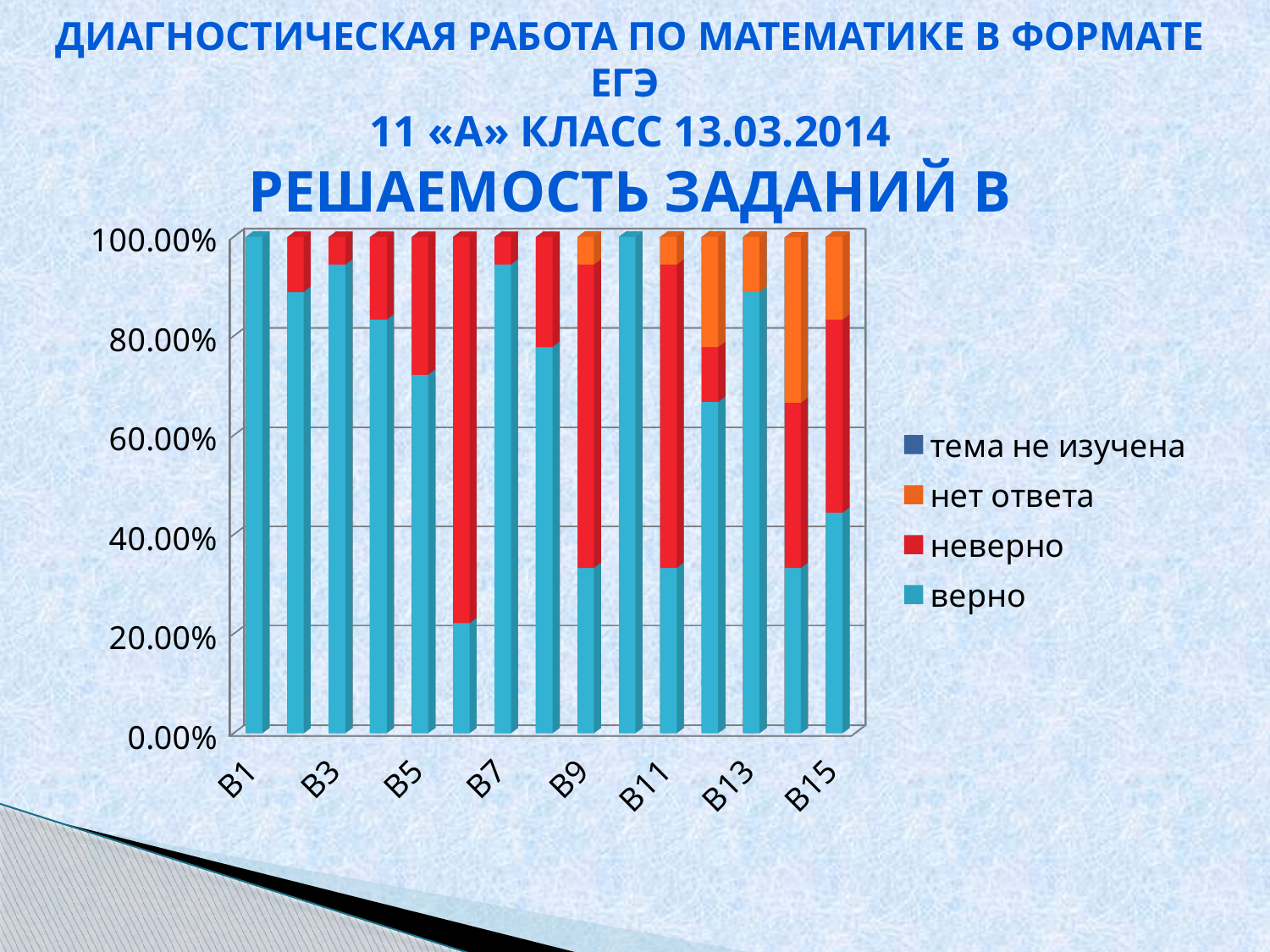
Is the 'верно' value for B1 greater or less than 80%? greater How many bars (tasks) are plotted on the chart? 15 Which task has the lowest value for the 'верно' series? B6 What kind of chart is shown on the slide? stacked bar chart Which has the larger 'верно' value, B4 or B6? B4 Is the 'верно' value for B6 greater or less than 40%? less Is the 'верно' value for B14 greater or less than 40%? less Which has the larger 'верно' value, B9 or B15? B15 How many series does the legend list? 4 What is the title of the chart? РЕШАЕМОСТЬ ЗАДАНИЙ В Which legend entry is shown in orange? нет ответа